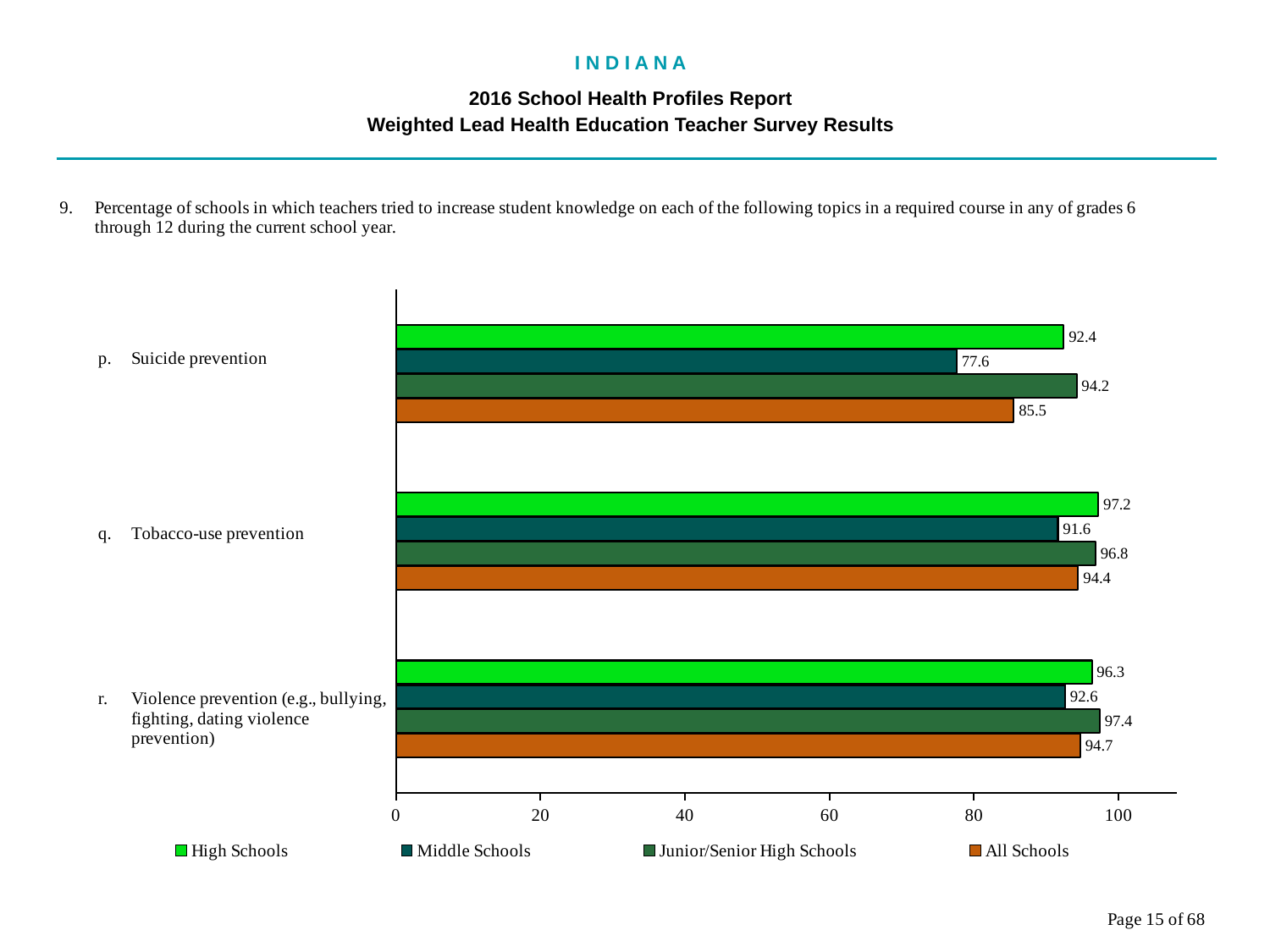
What is the difference between the High Schools and Middle Schools values for Suicide prevention? 14.8 Which school type has the lowest value for Suicide prevention? Middle Schools What is the value for Middle Schools for Suicide prevention? 77.6 What kind of chart is shown on the slide? bar chart Is the value for Middle Schools for Suicide prevention greater or less than 80? less Which legend entry is shown in orange? All Schools How many series does the legend list? 4 How many topics (categories) are shown on the chart? 3 Which school type has the highest value for Tobacco-use prevention? High Schools What is the value for Junior/Senior High Schools for Violence prevention? 97.4 What is the value for All Schools for Tobacco-use prevention? 94.4 Which is larger for Violence prevention: the High Schools value or the Middle Schools value? High Schools